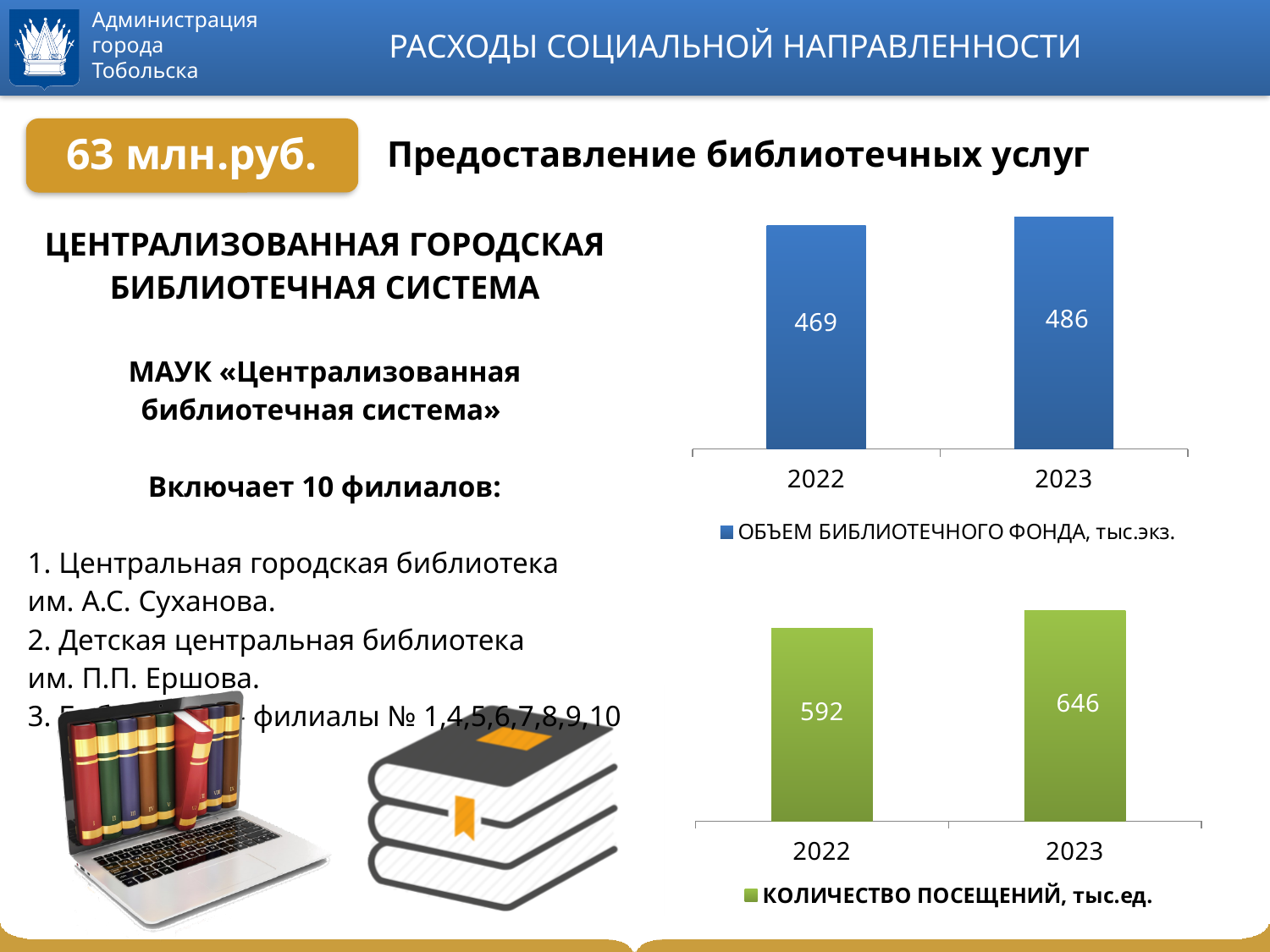
In the top chart (ОБЪЕМ БИБЛИОТЕЧНОГО ФОНДА, тыс.экз.), what is the value for 2023? 486 What kind of chart is the bottom chart (КОЛИЧЕСТВО ПОСЕЩЕНИЙ, тыс.ед.)? bar chart In the bottom chart (КОЛИЧЕСТВО ПОСЕЩЕНИЙ, тыс.ед.), what is the value for 2022? 592 In the bottom chart (КОЛИЧЕСТВО ПОСЕЩЕНИЙ, тыс.ед.), do the values rise or fall from 2022 to 2023? rise In the top chart (ОБЪЕМ БИБЛИОТЕЧНОГО ФОНДА, тыс.экз.), what is the difference between the 2023 and 2022 values? 17 In the top chart (ОБЪЕМ БИБЛИОТЕЧНОГО ФОНДА, тыс.экз.), which year has the higher value? 2023 What is the legend entry of the top chart? ОБЪЕМ БИБЛИОТЕЧНОГО ФОНДА, тыс.экз. In the bottom chart (КОЛИЧЕСТВО ПОСЕЩЕНИЙ, тыс.ед.), which year has the lower value? 2022 In the bottom chart (КОЛИЧЕСТВО ПОСЕЩЕНИЙ, тыс.ед.), what is the value for 2023? 646 In the bottom chart (КОЛИЧЕСТВО ПОСЕЩЕНИЙ, тыс.ед.), what is the difference between the 2023 and 2022 values? 54 How many categories (years) are shown in the top chart (ОБЪЕМ БИБЛИОТЕЧНОГО ФОНДА, тыс.экз.)? 2 In the top chart (ОБЪЕМ БИБЛИОТЕЧНОГО ФОНДА, тыс.экз.), what is the value for 2022? 469